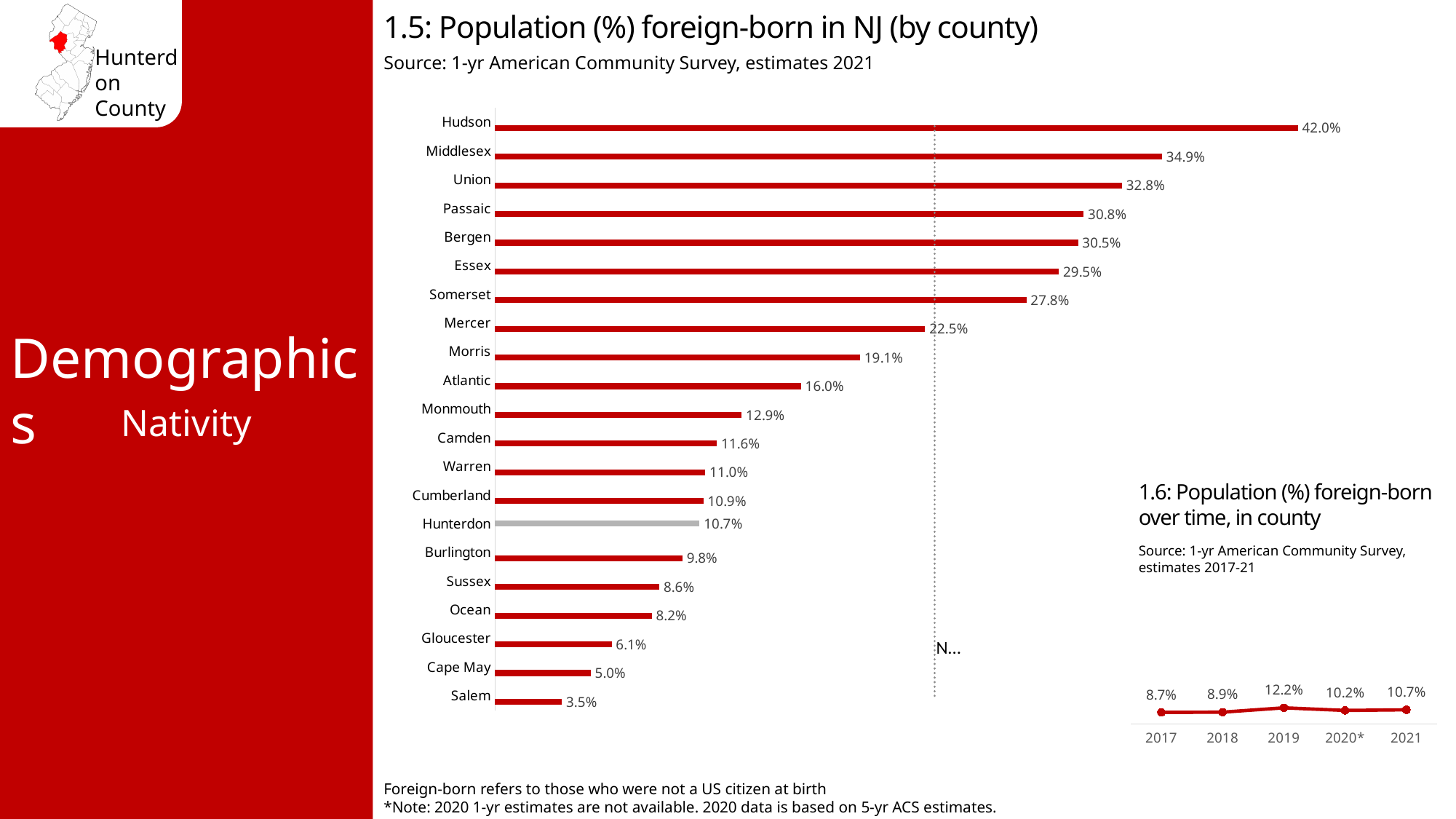
In chart 1.6 (Population (%) foreign-born over time, in county), what is the value for 2019? 12.2% In chart 1.5 (Population (%) foreign-born in NJ by county), which county has the highest value? Hudson In chart 1.5 (Population (%) foreign-born in NJ by county), what is the difference between Hudson and Middlesex? 7.1% In chart 1.5 (Population (%) foreign-born in NJ by county), which is larger, Morris or Atlantic? Morris In chart 1.5 (Population (%) foreign-born in NJ by county), what is the value for Bergen? 30.5% In chart 1.5 (Population (%) foreign-born in NJ by county), which county's bar is coloured grey instead of red? Hunterdon What kind of chart is chart 1.5 (Population (%) foreign-born in NJ by county)? Bar chart In chart 1.5 (Population (%) foreign-born in NJ by county), which county has the lowest value? Salem In chart 1.5 (Population (%) foreign-born in NJ by county), how many counties are shown? 21 In chart 1.6 (Population (%) foreign-born over time, in county), which year has the lowest value? 2017 In chart 1.5 (Population (%) foreign-born in NJ by county), what is the value for Hunterdon? 10.7% In chart 1.6 (Population (%) foreign-born over time, in county), what is the difference between 2021 and 2017? 2.0%